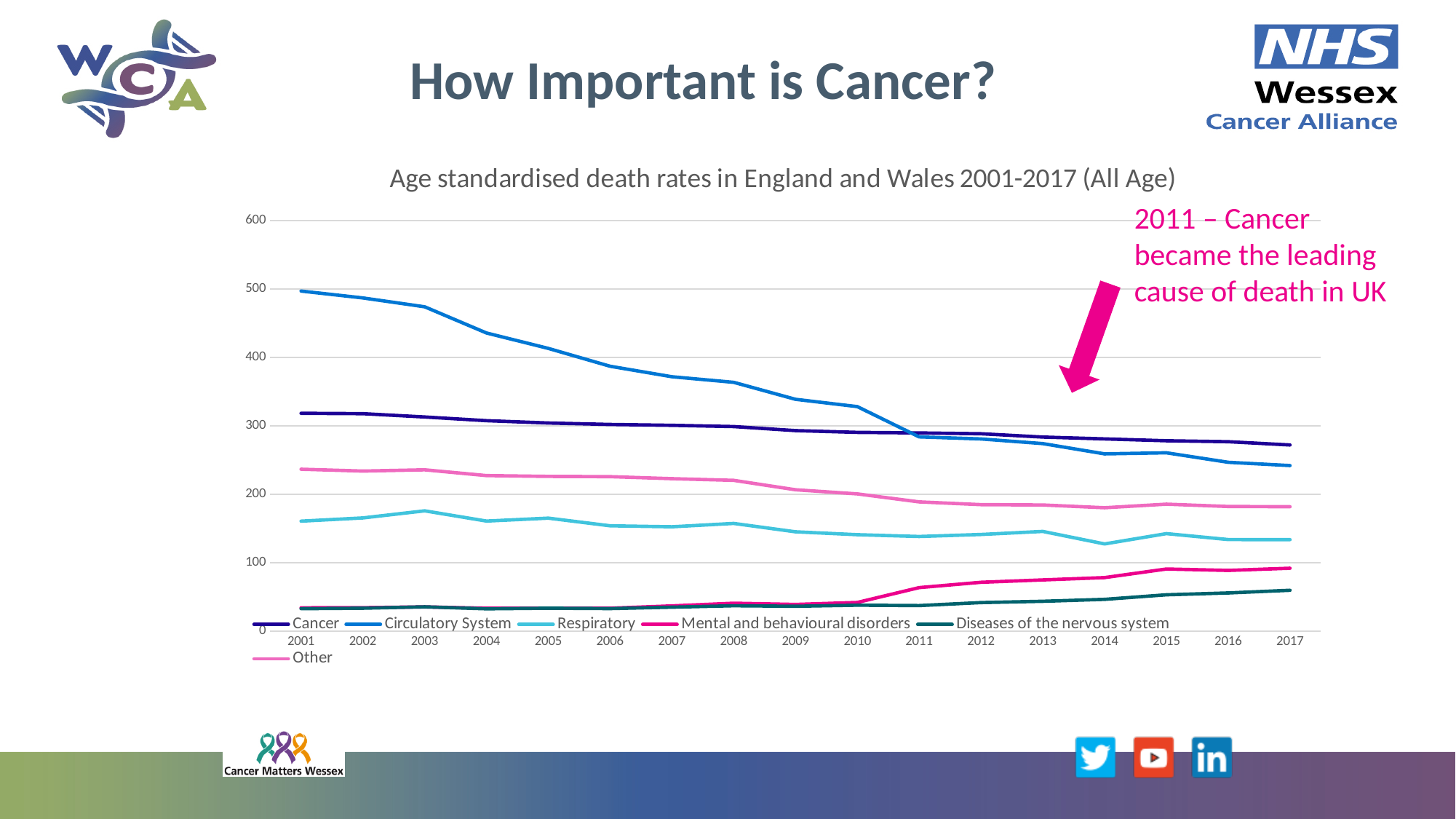
Does the Circulatory System line rise or fall from 2001 to 2017? Fall How many series does the legend list? 6 What kind of chart is shown on the slide? Line chart Which series has the highest value in 2017? Cancer What is the title of the chart? Age standardised death rates in England and Wales 2001-2017 (All Age) In 2001, which is higher: Cancer or Circulatory System? Circulatory System Is the value for Cancer in 2017 greater or less than 300? less Is the value for Other in 2001 greater or less than 200? greater Is the value for Circulatory System in 2001 greater or less than 400? greater How many years are plotted along the x axis? 17 Does the Mental and behavioural disorders line rise or fall from 2001 to 2017? Rise